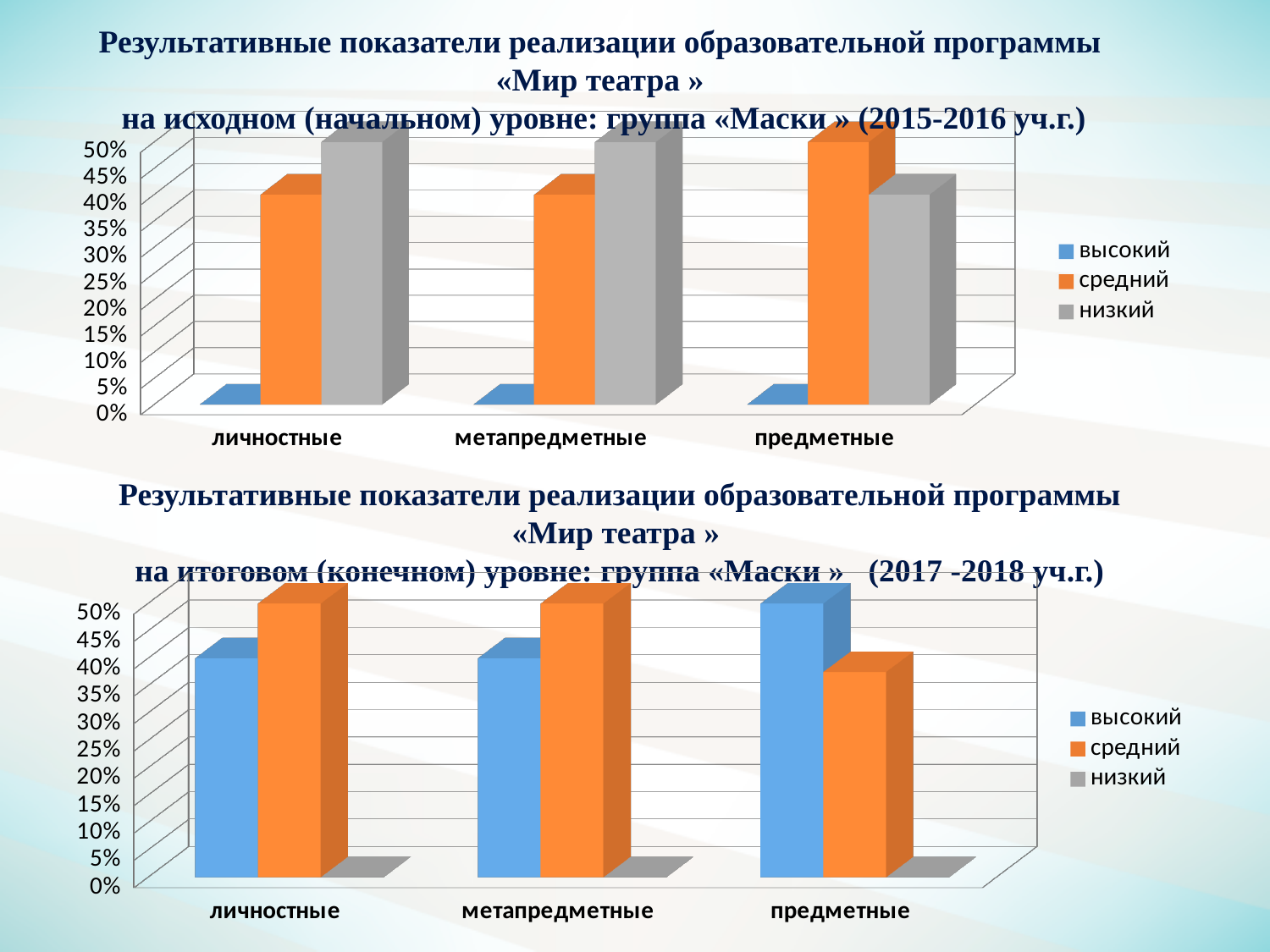
In the top chart (2015-2016 уч.г.), is the value for высокий in the метапредметные category greater or less than 10%? less In the bottom chart (2017-2018 уч.г.), which series is shown in blue? высокий In the top chart (2015-2016 уч.г.), is the value for низкий in the личностные category greater or less than 30%? greater Which group is named in the title of the top chart? группа «Маски» How many categories are shown on the x axis of the bottom chart (2017-2018 уч.г.)? 3 In the top chart (2015-2016 уч.г.), which is larger for the предметные category: средний or низкий? средний In the bottom chart (2017-2018 уч.г.), which is larger for the метапредметные category: высокий or средний? средний In the bottom chart (2017-2018 уч.г.), is the value for высокий in the предметные category greater or less than 45%? greater How many series does the legend of the top chart (2015-2016 уч.г.) list? 3 In the top chart (2015-2016 уч.г.), which is larger for the личностные category: средний or низкий? низкий What kind of chart is the top chart (2015-2016 уч.г.)? bar chart